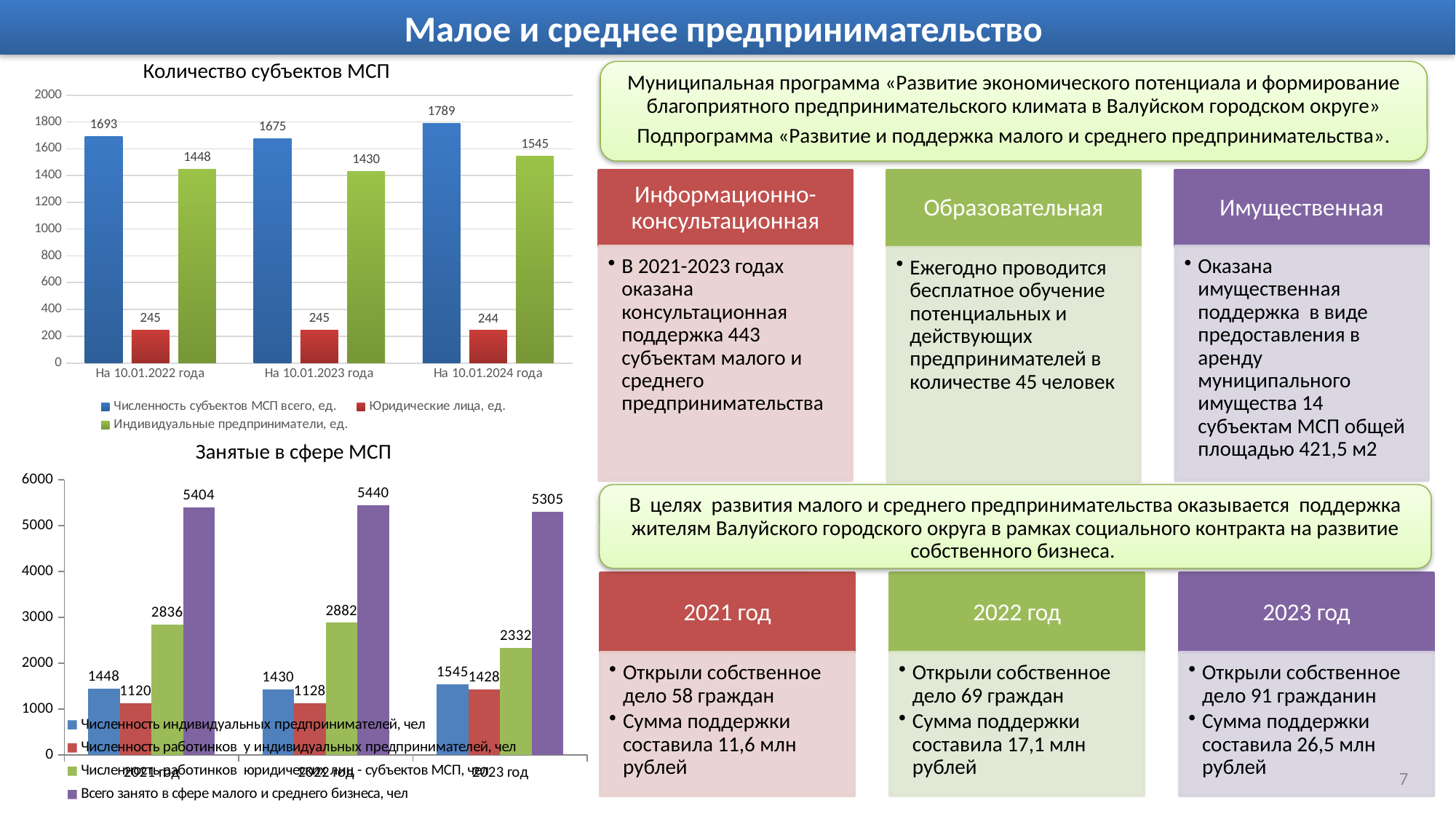
На диаграмме «Занятые в сфере МСП» сколько всего занято в сфере малого и среднего бизнеса в 2022 году? 5440 Какого типа диаграмма «Количество субъектов МСП»? Столбчатая (bar chart) На диаграмме «Количество субъектов МСП» сколько серий указано в легенде? 3 На диаграмме «Занятые в сфере МСП» какова численность работников у индивидуальных предпринимателей в 2023 году? 1428 На диаграмме «Количество субъектов МСП» на сколько выросло число индивидуальных предпринимателей с 10.01.2023 года по 10.01.2024 года? 115 На диаграмме «Количество субъектов МСП» сколько юридических лиц на 10.01.2023 года? 245 На диаграмме «Количество субъектов МСП» в какую дату численность субъектов МСП всего была наименьшей? На 10.01.2023 года На диаграмме «Занятые в сфере МСП» на сколько уменьшилось общее число занятых в сфере малого и среднего бизнеса с 2022 по 2023 год? 135 На диаграмме «Количество субъектов МСП» какова численность субъектов МСП всего на 10.01.2024 года? 1789 На диаграмме «Занятые в сфере МСП» что больше: численность работников юридических лиц в 2021 году или в 2023 году? В 2021 году На диаграмме «Занятые в сфере МСП» в каком году численность работников юридических лиц — субъектов МСП была наибольшей? 2022 год На диаграмме «Занятые в сфере МСП» сколько категорий (годов) показано по оси x? 3